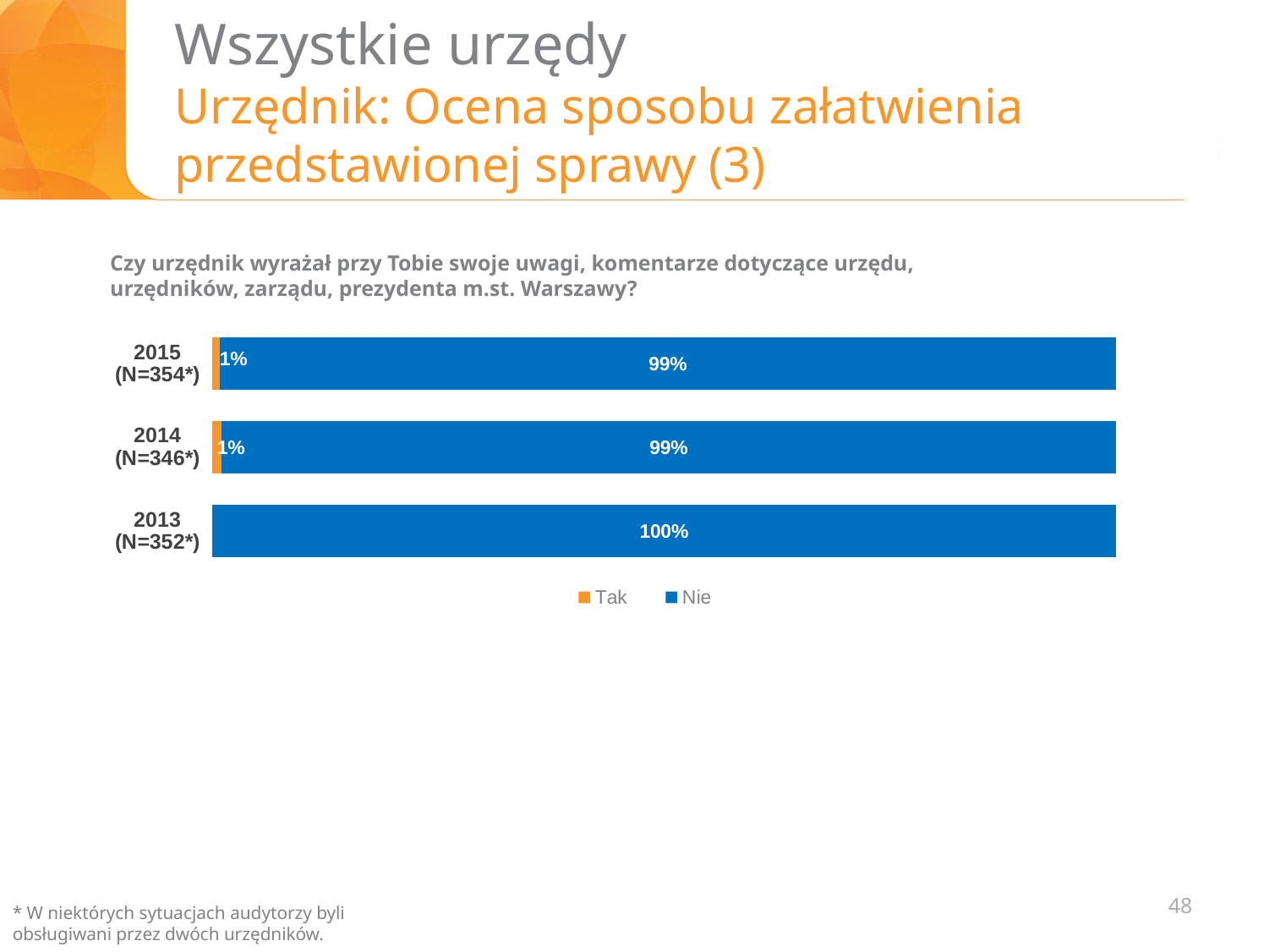
How many series does the legend list? 2 What is the total of the stacked bar for 2014 (N=346*)? 100% What is the value for "Nie" in 2015 (N=354*)? 99% What is the difference between the "Nie" value in 2013 and the "Nie" value in 2014? 1% What is the value for "Nie" in 2013 (N=352*)? 100% Which year has the highest value for "Nie"? 2013 (N=352*) What kind of chart is shown on the slide? Stacked horizontal bar chart How many year categories are shown in the chart? 3 What is the value for "Tak" in 2015 (N=354*)? 1% Which is larger in 2015: the value for "Tak" or the value for "Nie"? Nie Which colour represents the "Tak" series in the legend? Orange What is the value for "Tak" in 2014 (N=346*)? 1%